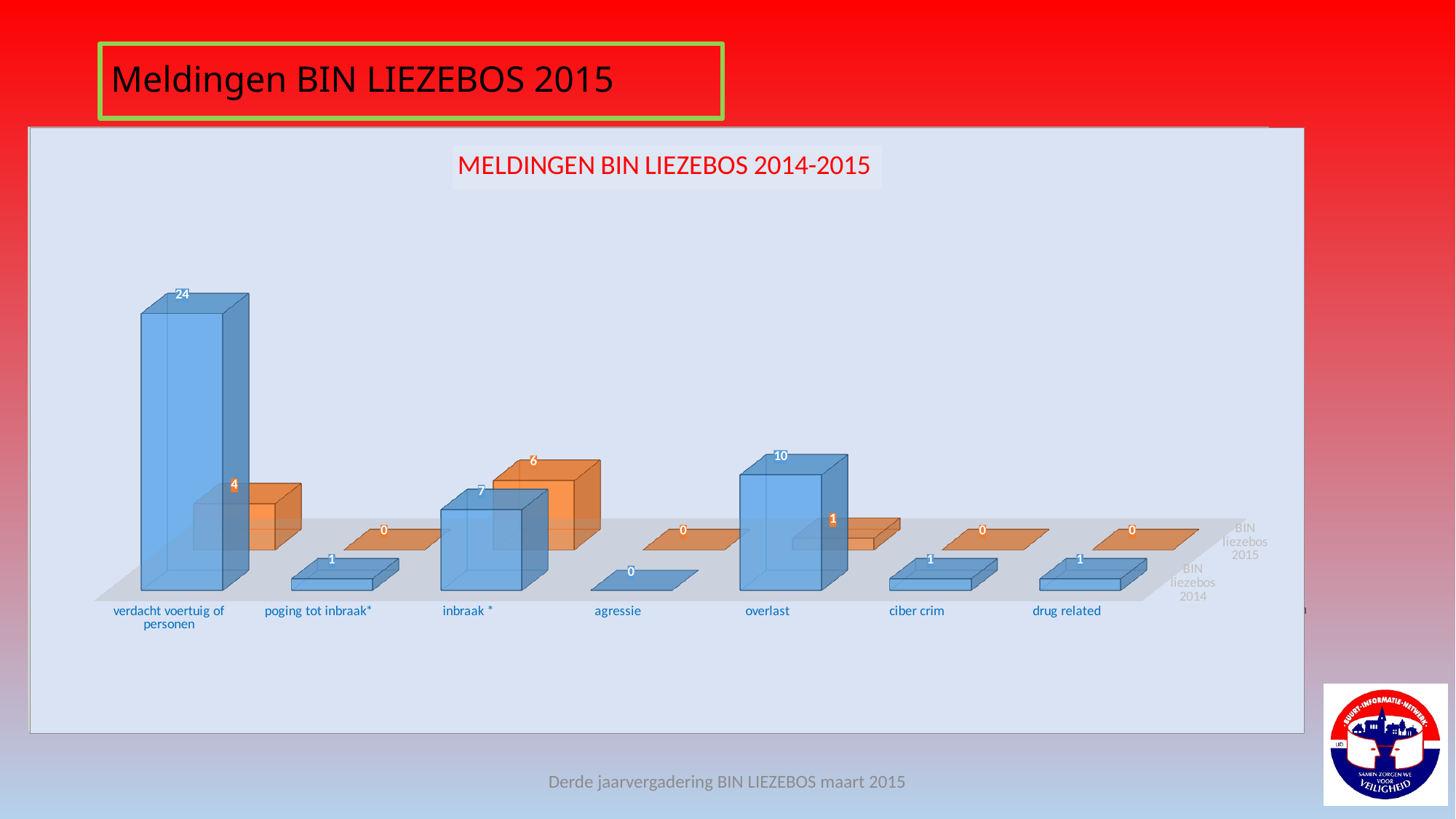
Which is larger for 'overlast': the BIN liezebos 2014 value or the BIN liezebos 2015 value? BIN liezebos 2014 What is the title of the chart? MELDINGEN BIN LIEZEBOS 2014-2015 What is the value for 'inbraak *' in the BIN liezebos 2015 series? 6 What is the value for 'overlast' in the BIN liezebos 2014 series? 10 How many categories are shown on the x axis of the chart? 7 Which category has the highest value in the BIN liezebos 2014 series? verdacht voertuig of personen What is the value for 'verdacht voertuig of personen' in the BIN liezebos 2014 series? 24 How many data series does the chart show? 2 Which category has the highest value in the BIN liezebos 2015 series? inbraak * What is the difference between the BIN liezebos 2014 and BIN liezebos 2015 values for 'verdacht voertuig of personen'? 20 What is the value for 'agressie' in the BIN liezebos 2014 series? 0 What kind of chart is shown on the slide? bar chart